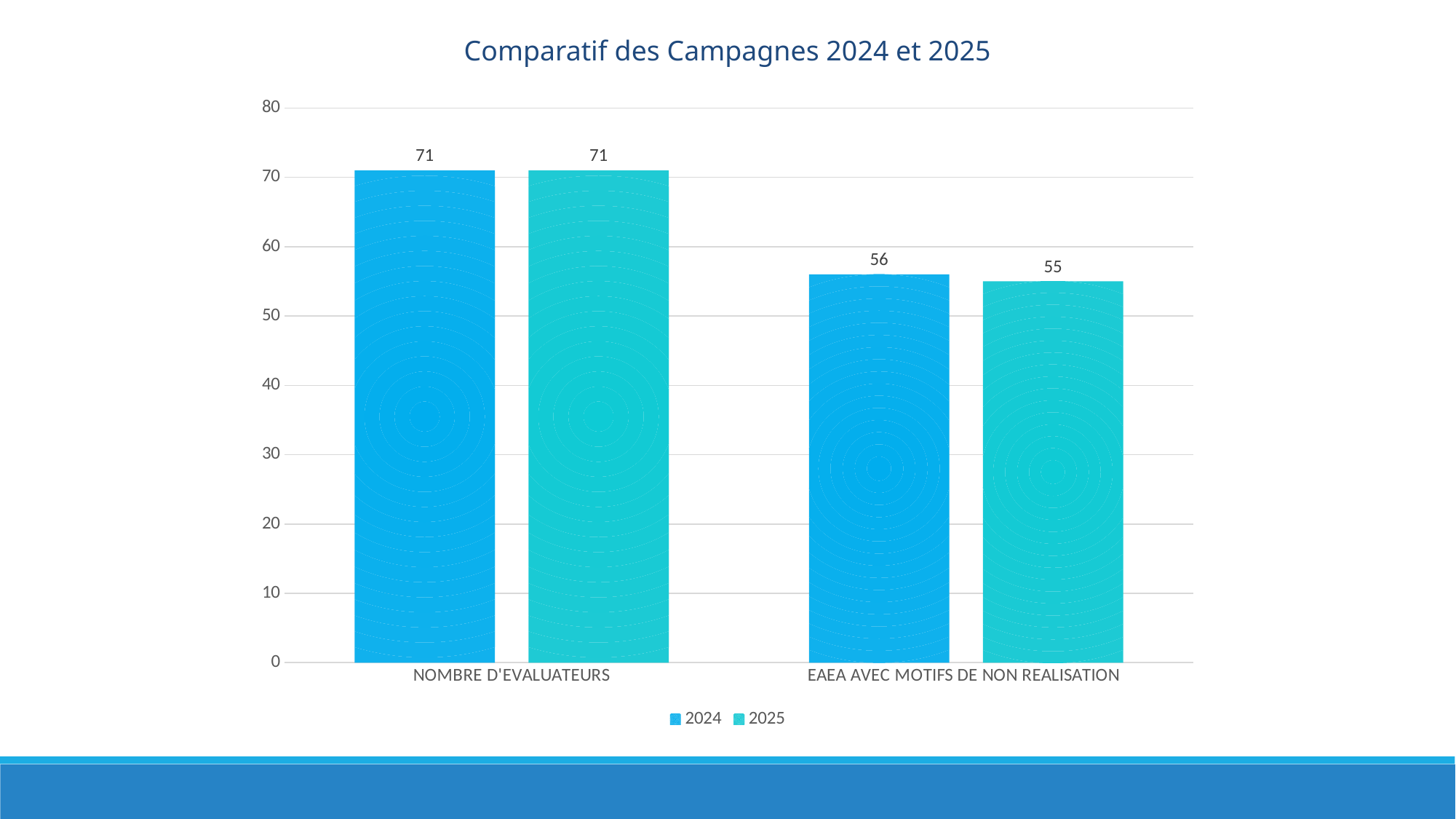
What kind of chart is shown on the slide? bar chart Which category has the lowest value for the 2025 series? EAEA AVEC MOTIFS DE NON REALISATION What is the value for 2025 in the NOMBRE D'EVALUATEURS category? 71 Is the 2024 value for NOMBRE D'EVALUATEURS greater or less than 60? greater What is the difference between the 2024 and 2025 values for EAEA AVEC MOTIFS DE NON REALISATION? 1 What is the value for 2024 in the EAEA AVEC MOTIFS DE NON REALISATION category? 56 How many categories are shown on the x axis? 2 What is the difference between the 2024 values for NOMBRE D'EVALUATEURS and EAEA AVEC MOTIFS DE NON REALISATION? 15 How many series does the legend list? 2 What is the value for 2025 in the EAEA AVEC MOTIFS DE NON REALISATION category? 55 What is the value for 2024 in the NOMBRE D'EVALUATEURS category? 71 Which category has the highest value for the 2024 series? NOMBRE D'EVALUATEURS